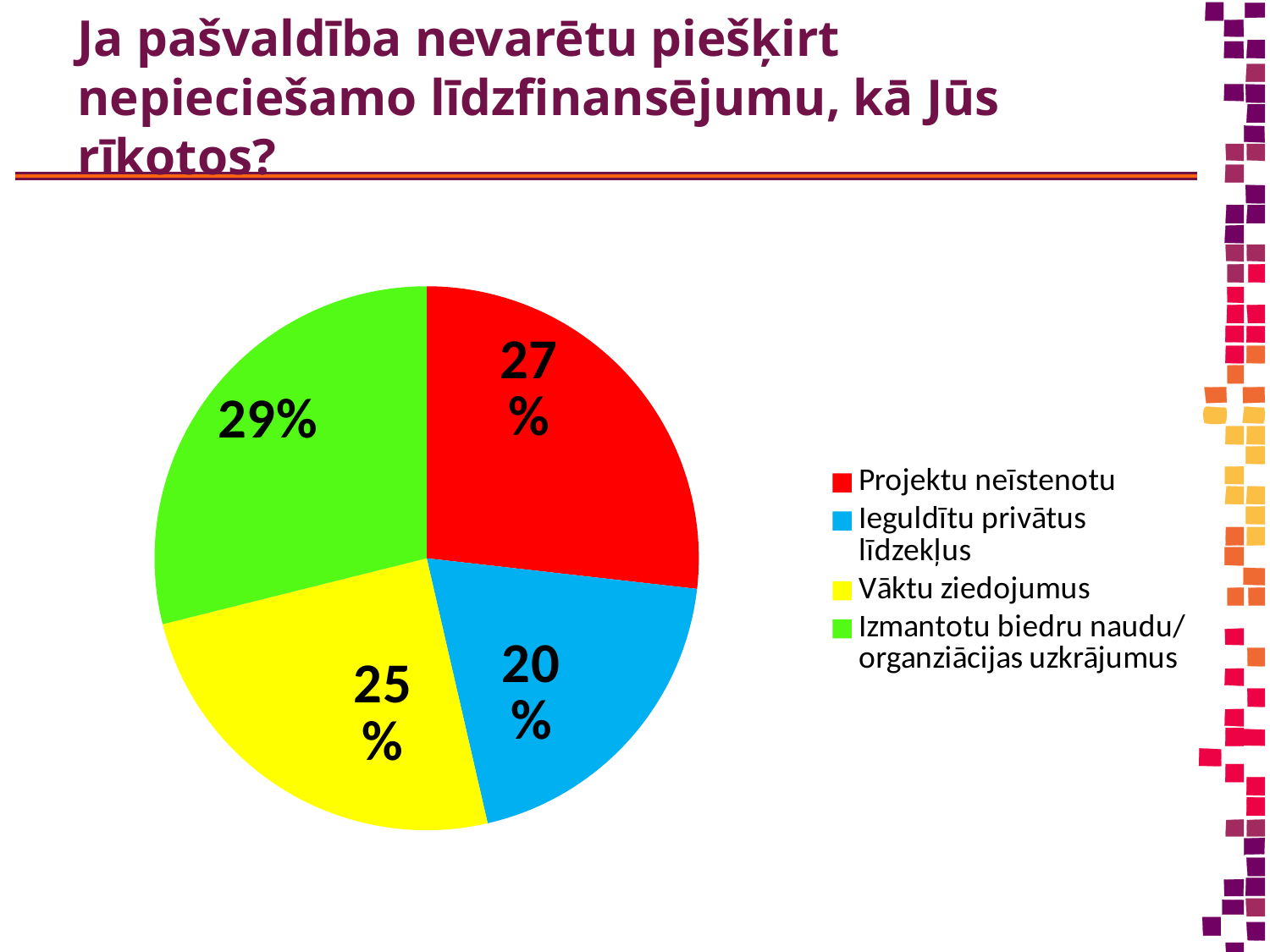
Which is larger, the slice for "Projektu neīstenotu" or the slice for "Vāktu ziedojumus"? Projektu neīstenotu Which category has the smallest slice of the pie? Ieguldītu privātus līdzekļus What share of the pie does "Vāktu ziedojumus" have? 25% Which category has the largest slice of the pie? Izmantotu biedru naudu/ organziācijas uzkrājumus What kind of chart is shown on the slide? pie chart What colour is the slice for "Vāktu ziedojumus"? yellow What is the difference in percentage points between "Izmantotu biedru naudu/ organziācijas uzkrājumus" and "Ieguldītu privātus līdzekļus"? 9 How many slices does the pie chart have? 4 What share of the pie does "Ieguldītu privātus līdzekļus" have? 20% What colour is the slice for "Projektu neīstenotu"? red What share of the pie does "Projektu neīstenotu" have? 27%